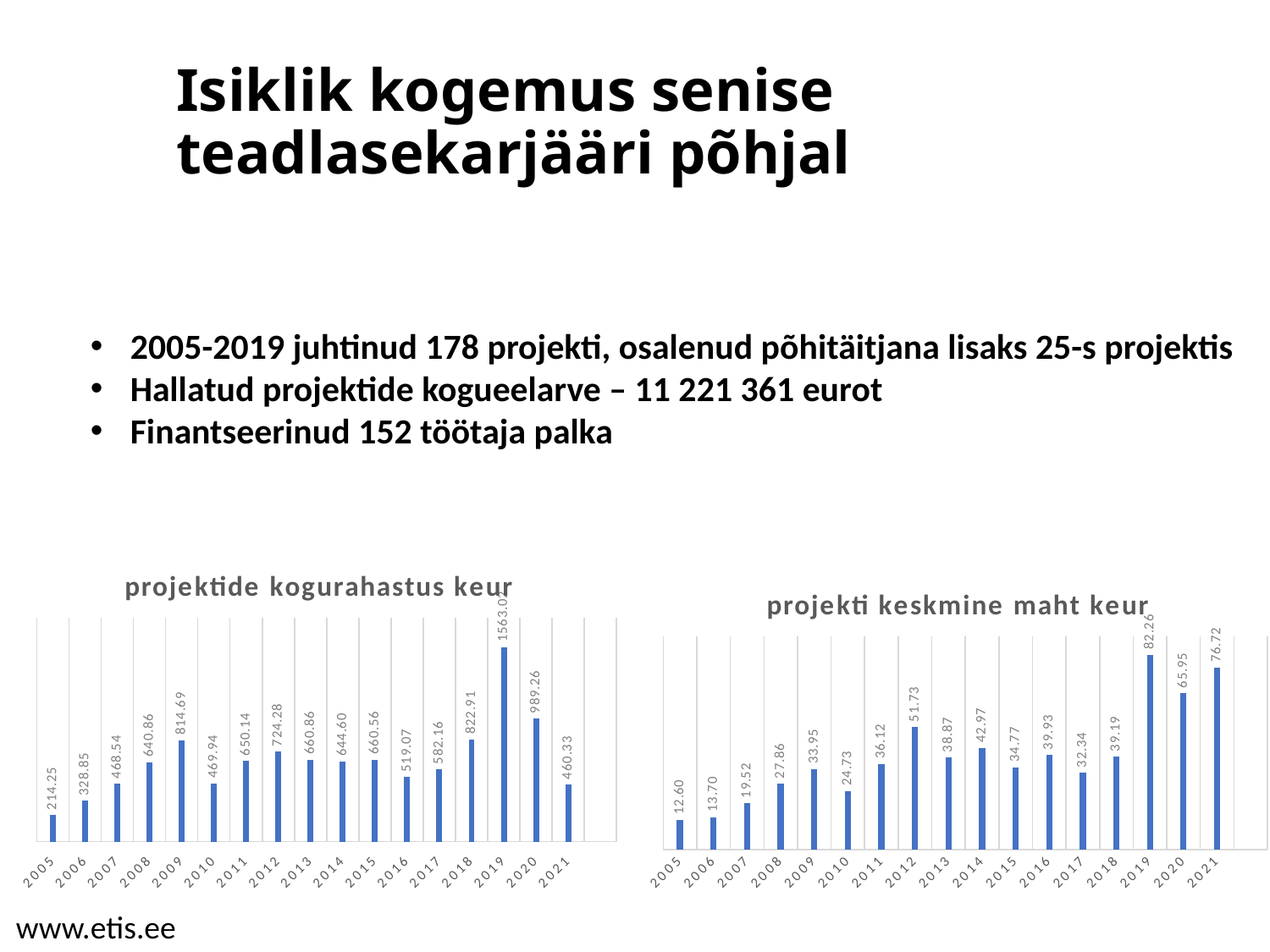
What kind of chart is 'projektide kogurahastus keur'? Bar chart In the chart 'projektide kogurahastus keur', what is the value for 2009? 814.69 In the chart 'projektide kogurahastus keur', what is the difference between the values for 2020 and 2021? 528.93 In the chart 'projekti keskmine maht keur', what is the value for 2012? 51.73 How many years are shown on the x axis of the chart 'projekti keskmine maht keur'? 17 In the chart 'projekti keskmine maht keur', which year has the highest value? 2019 In the chart 'projektide kogurahastus keur', which is larger, the value for 2012 or the value for 2016? 2012 In the chart 'projektide kogurahastus keur', which year has the highest value? 2019 In the chart 'projekti keskmine maht keur', what is the value for 2021? 76.72 In the chart 'projekti keskmine maht keur', what is the difference between the values for 2019 and 2020? 16.31 In the chart 'projekti keskmine maht keur', which year has the lowest value? 2005 In the chart 'projektide kogurahastus keur', what is the value for 2020? 989.26